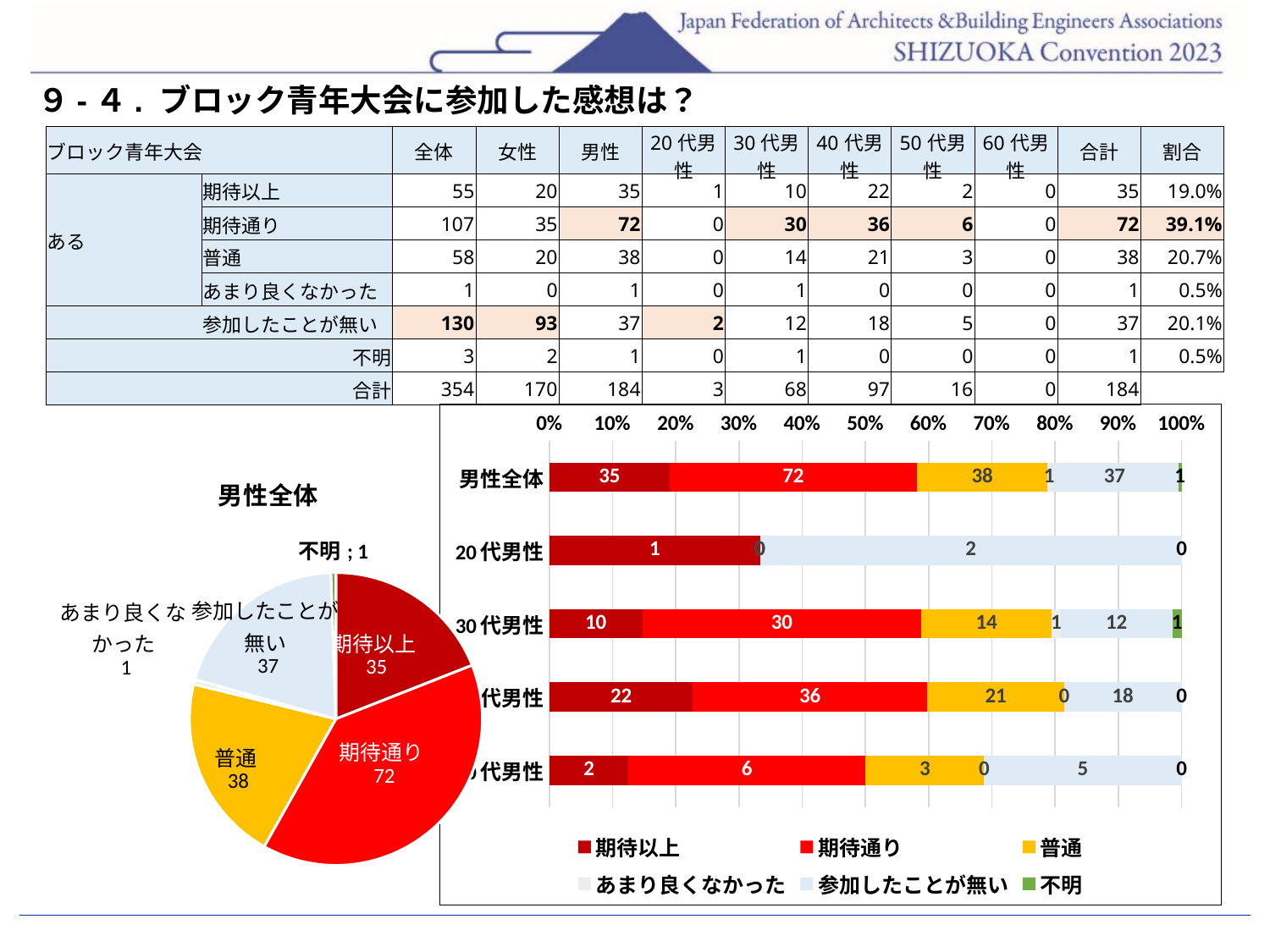
What kind of chart is the chart titled 男性全体 on the left of the slide? pie chart In the pie chart titled 男性全体, what is the value for 参加したことが無い? 37 In the pie chart titled 男性全体, which category has the largest slice? 期待通り In the stacked bar chart on the right, what is the difference between 期待通り and 期待以上 for 男性全体? 37 How many series does the legend of the stacked bar chart on the right list? 6 In the stacked bar chart on the right, what is the value of 普通 for 男性全体? 38 What kind of chart is the chart on the right of the slide with the percentage axis? bar chart In the stacked bar chart on the right, what is the value of 期待通り for 30代男性? 30 How many categories (bars) are shown in the stacked bar chart on the right? 5 In the pie chart titled 男性全体, what is the value for 期待通り? 72 In the stacked bar chart on the right, what is the total of all segments in the 男性全体 bar? 184 In the stacked bar chart on the right, what is the value of 参加したことが無い for 20代男性? 2